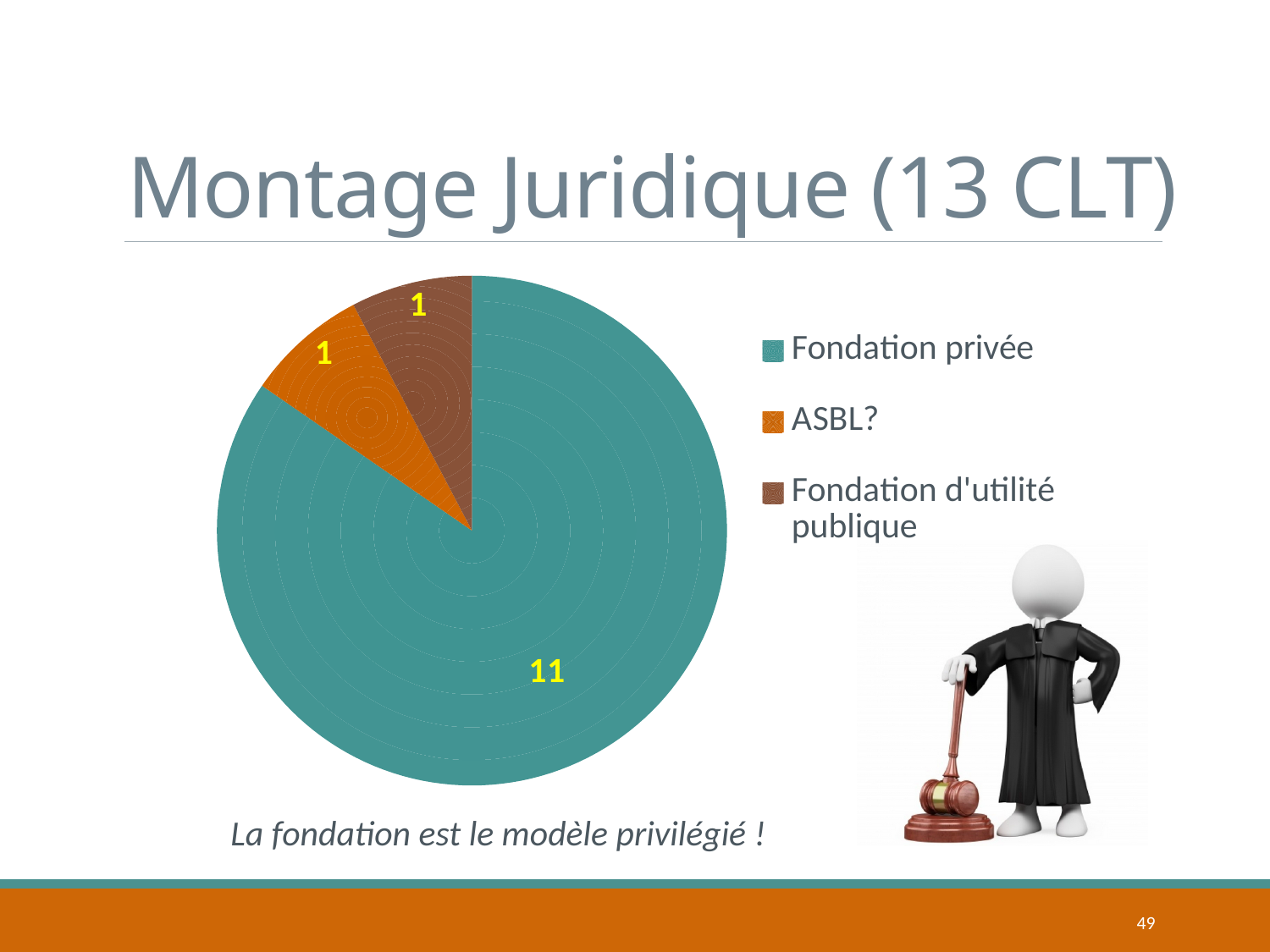
What type of chart is shown on the slide? pie chart What is the difference between the value for Fondation privée and the value for ASBL? 10 Which category has the largest slice of the pie? Fondation privée Is the value for ASBL? larger than, smaller than, or equal to the value for Fondation d'utilité publique? equal Which is larger, the value for Fondation privée or the value for Fondation d'utilité publique? Fondation privée How many entries does the legend list? 3 What is the value for Fondation d'utilité publique? 1 How many categories does the pie chart show? 3 What is the total of all the slices in the pie chart? 13 What is the value for ASBL? 1 What is the value for Fondation privée? 11 What is the title of the slide containing the pie chart? Montage Juridique (13 CLT)